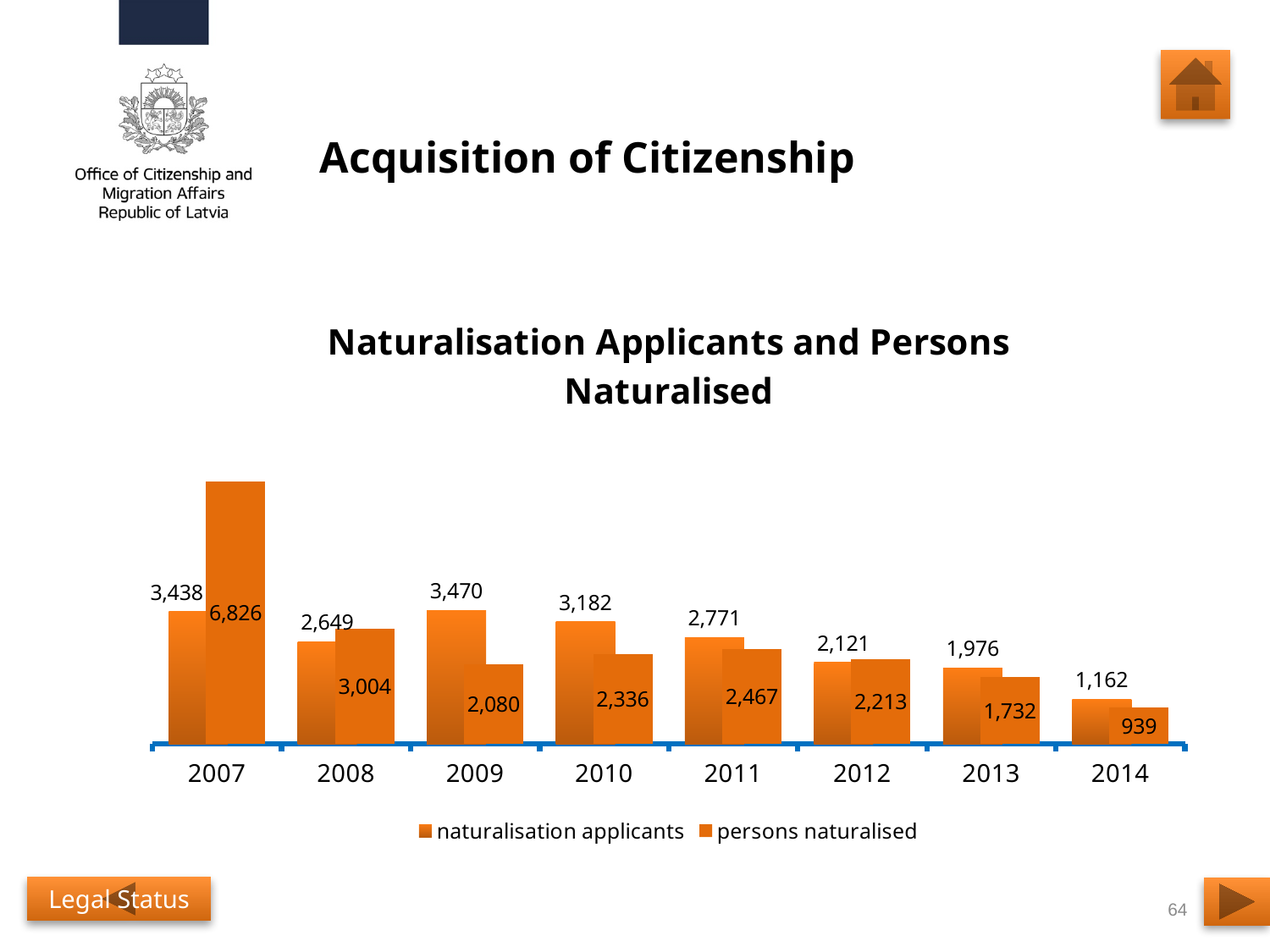
What is the difference between naturalisation applicants and persons naturalised in 2013? 244 In which year was the number of persons naturalised the lowest? 2014 How many series does the legend list? 2 How many persons were naturalised in 2012? 2,213 How many years are shown on the x axis? 8 How many naturalisation applicants were there in 2009? 3,470 How many persons were naturalised in 2007? 6,826 What type of chart is shown on the slide? bar chart In which year was the number of naturalisation applicants the highest? 2009 What is the title of the chart? Naturalisation Applicants and Persons Naturalised In 2011, which was larger: naturalisation applicants or persons naturalised? naturalisation applicants From 2011 to 2014, do the numbers of naturalisation applicants rise or fall? fall